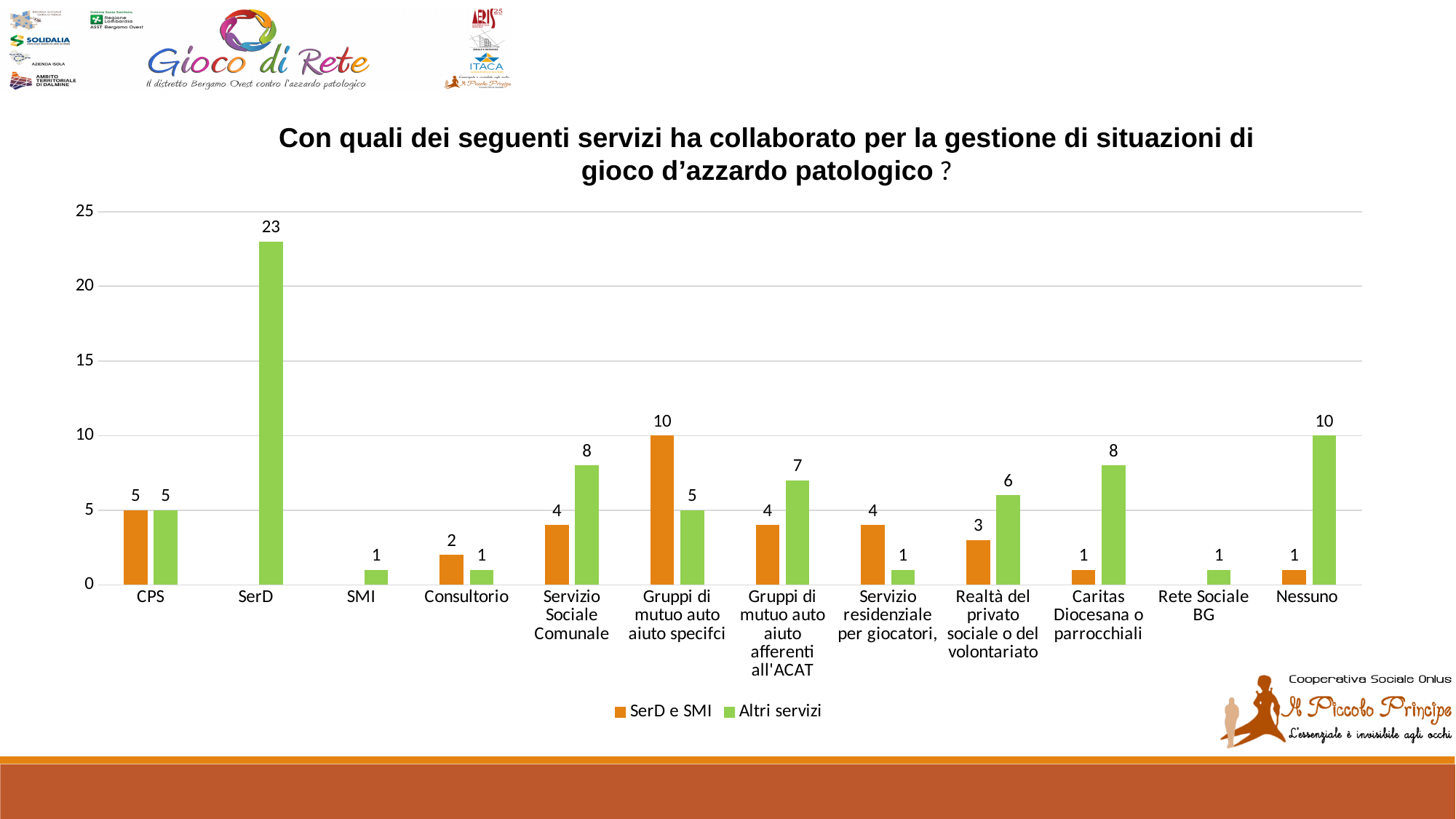
What kind of chart is shown on the slide? bar chart How many categories are shown on the x axis? 12 What is the value for Altri servizi for SerD? 23 Which category has the highest value for Altri servizi? SerD What is the difference between the Altri servizi value for SerD and the Altri servizi value for Nessuno? 13 For Servizio Sociale Comunale, which series has the larger value, SerD e SMI or Altri servizi? Altri servizi What is the value for SerD e SMI for Gruppi di mutuo auto aiuto specifci? 10 How many series does the legend list? 2 Which category has the highest value for SerD e SMI? Gruppi di mutuo auto aiuto specifci What is the value for SerD e SMI for Realtà del privato sociale o del volontariato? 3 What is the value for Altri servizi for Caritas Diocesana o parrocchiali? 8 Is the Altri servizi value for SerD greater or less than 20? greater